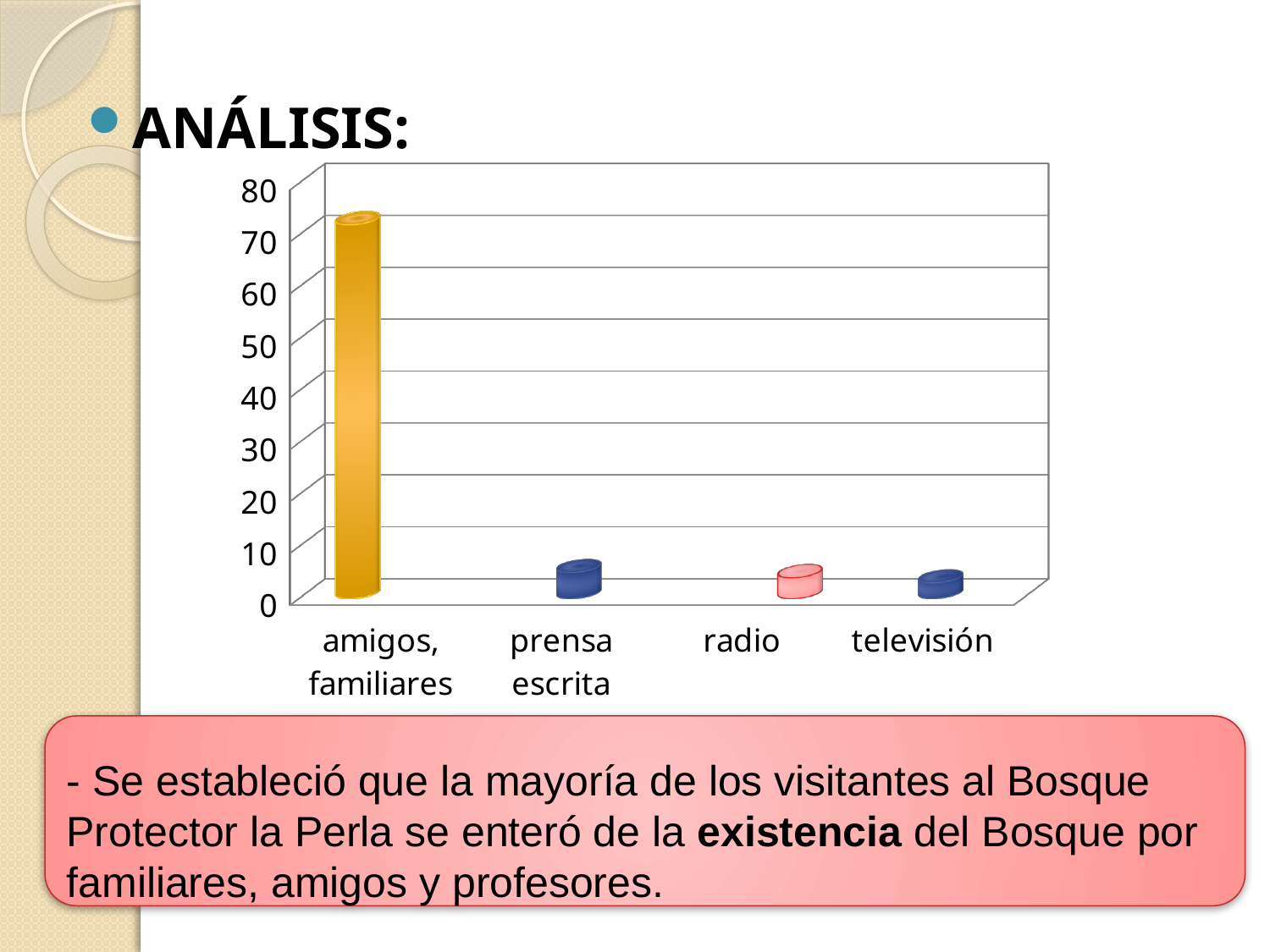
Is the value for televisión greater or less than 10? less Is the value for prensa escrita greater or less than 10? less Is the value for radio greater or less than 10? less What kind of chart is shown on the slide? bar chart How many categories are shown on the x axis of the chart? 4 Which is larger, the value for amigos, familiares or the value for radio? amigos, familiares Which is larger, the value for prensa escrita or the value for amigos, familiares? amigos, familiares What is the highest value shown on the y axis of the chart? 80 What colour is the bar for amigos, familiares? orange Which category has the highest value in the chart? amigos, familiares